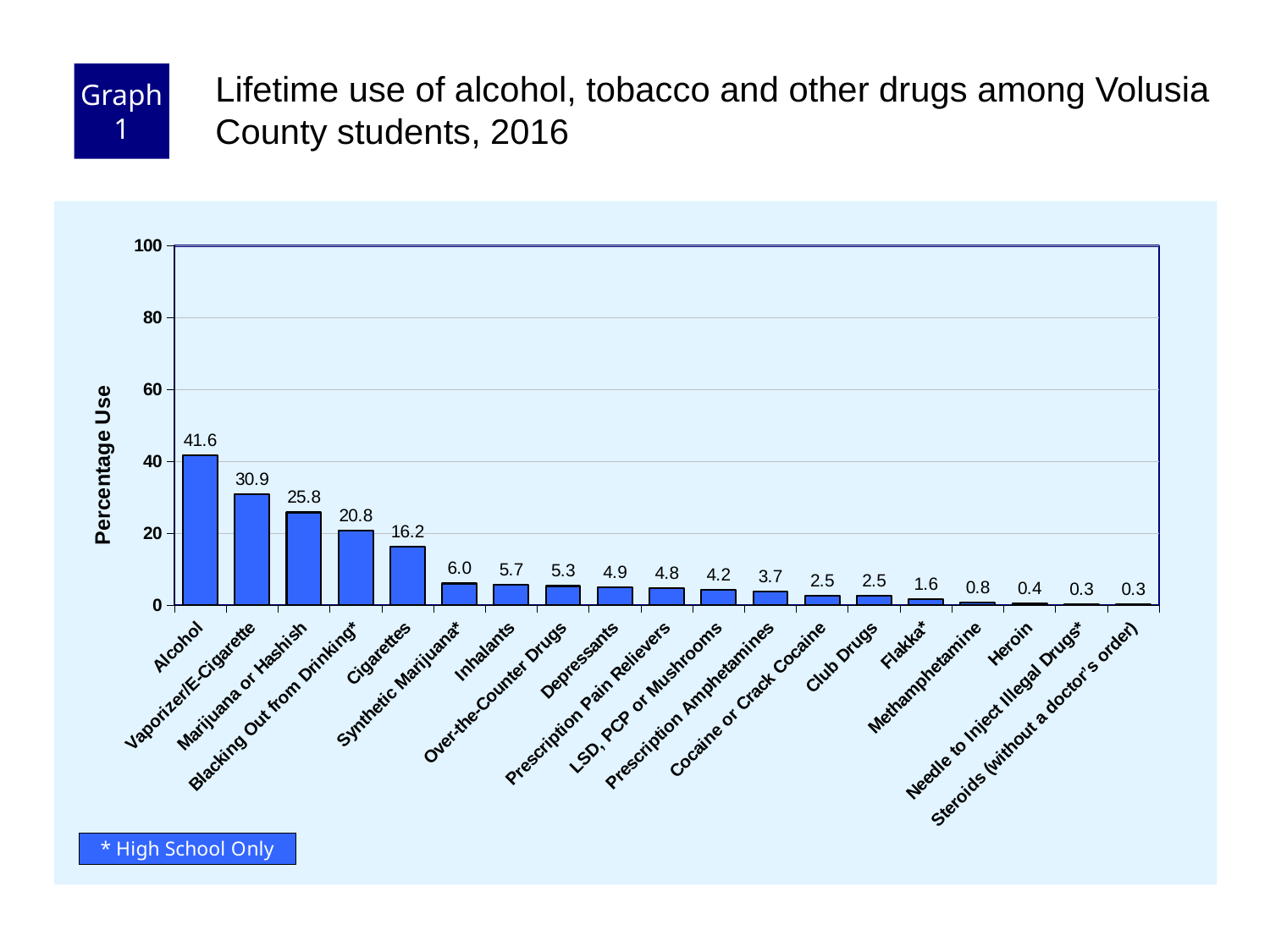
What is the value shown for Cigarettes? 16.2 Is the value for Vaporizer/E-Cigarette greater or less than 20? greater What is the lifetime use percentage for Alcohol? 41.6 What is the value shown for Heroin? 0.4 What is the label of the y axis? Percentage Use Which category has the highest lifetime use percentage? Alcohol How many categories are shown on the x axis of the chart? 19 What is the value shown for Vaporizer/E-Cigarette? 30.9 What kind of chart is shown on the slide? Bar chart What is the difference between the values for Alcohol and Marijuana or Hashish? 15.8 Which is larger, the value for Inhalants or the value for Depressants? Inhalants What is the difference between the values for Blacking Out from Drinking* and Cigarettes? 4.6